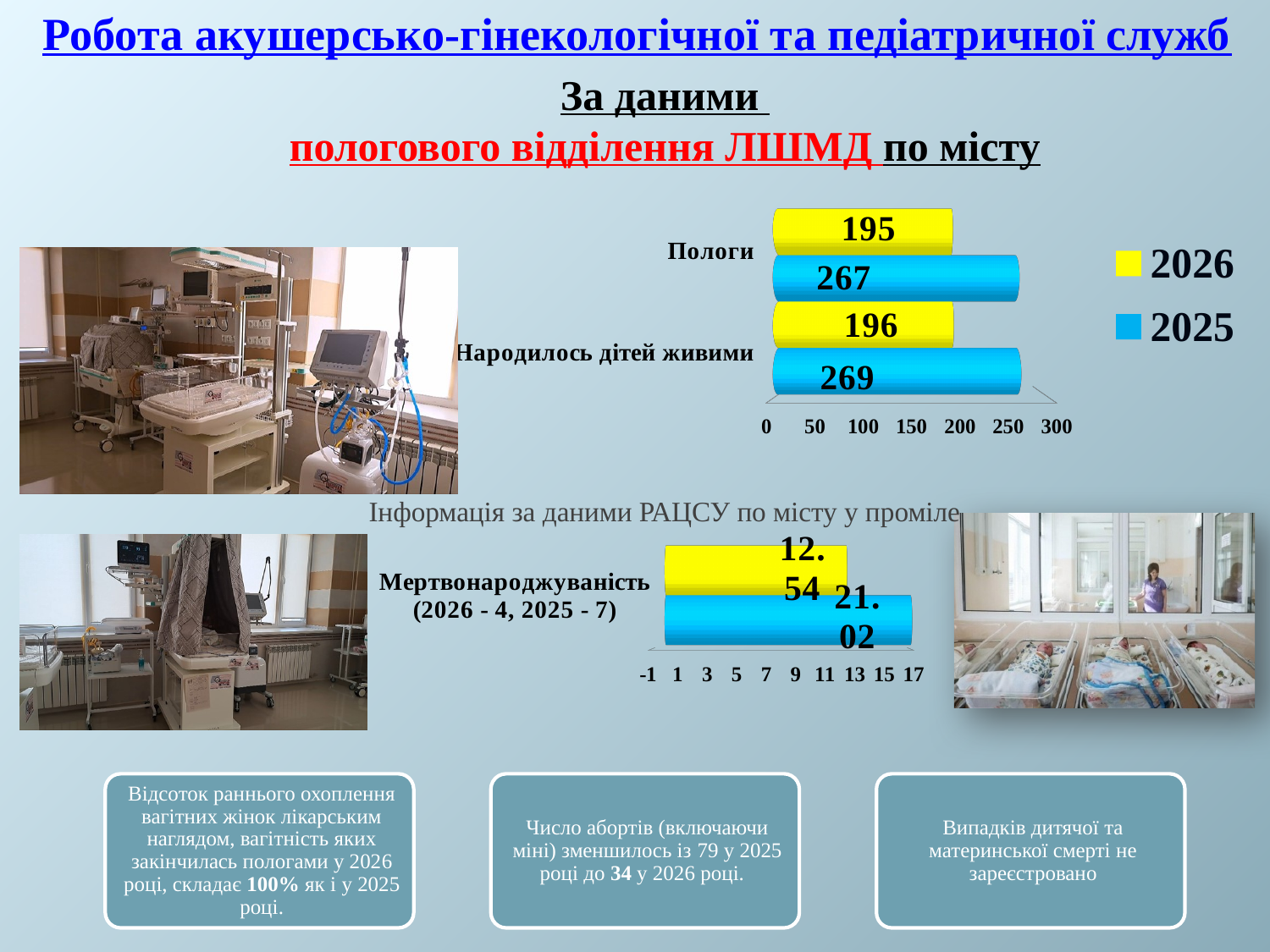
In the top chart, what is the value for Народилось дітей живими in 2026? 196 In the bottom chart (Мертвонароджуваність), what is the value of the blue (2025) bar? 21.02 How many series does the legend of the top chart list? 2 What kind of chart is the top chart? bar chart In the top chart, what is the difference between the 2025 and 2026 values for Народилось дітей живими? 73 In the top chart, what is the value for Пологи in 2026? 195 In the top chart, what is the value for Пологи in 2025? 267 In the top chart, what is the value for Народилось дітей живими in 2025? 269 How many categories are shown in the top chart? 2 In the bottom chart (Мертвонароджуваність), what is the value of the yellow (2026) bar? 12.54 In the top chart, what is the difference between the 2025 and 2026 values for Пологи? 72 In the top chart, which year has the larger value for Пологи, 2026 or 2025? 2025